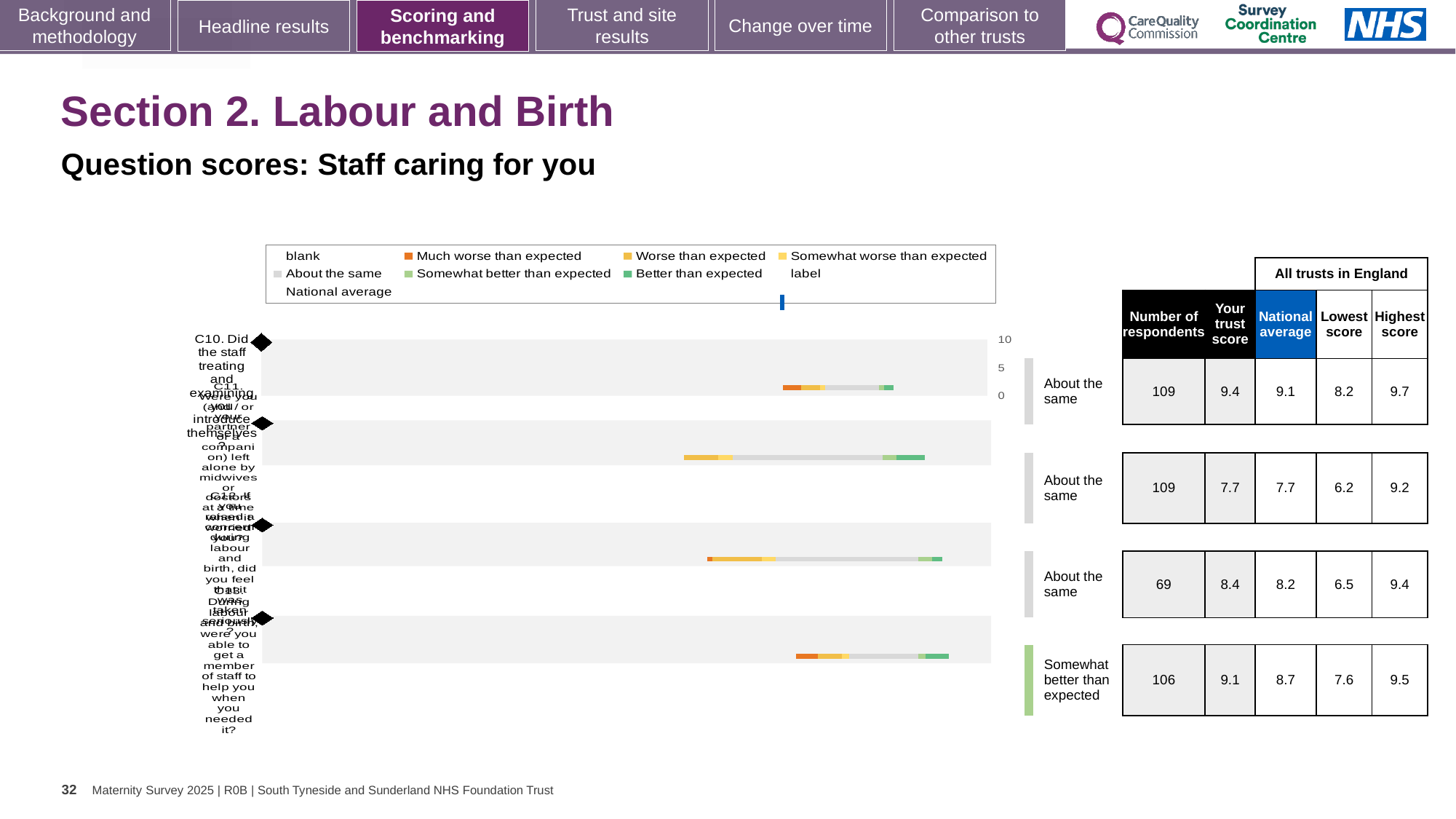
What is the highest score among all trusts in England for the third row (C12)? 9.4 What is the lowest score among all trusts in England for the second row (C11)? 6.2 What is the national average for the first row (C10)? 9.1 How many questions (rows) are plotted in the chart? 4 What kind of chart is shown on the slide? bar chart What is the number of respondents for the first row (C10)? 109 For the last row (C13), which is larger: the trust score or the national average? the trust score (9.1) Which row is rated 'Somewhat better than expected' rather than 'About the same'? the last row (C13) Which row has the highest 'Your trust score'? C10 (first row), 9.4 What is the 'Your trust score' for the last row (C13, getting a member of staff to help you when you needed it)? 9.1 Which row has the lowest 'Your trust score'? the second row (C11), 7.7 By how much does the trust score for C10 exceed its national average? 0.3